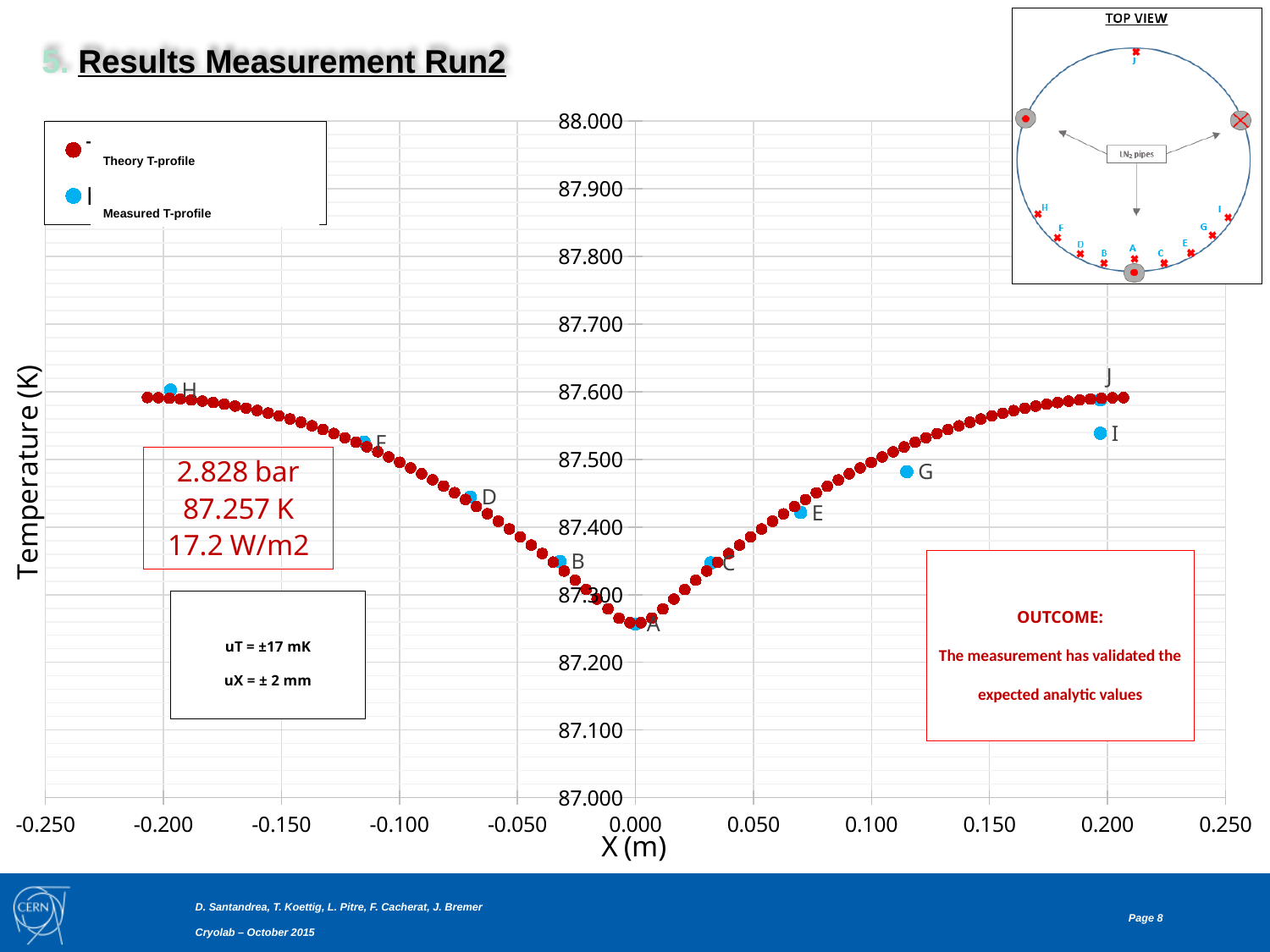
Is the measured temperature at point A greater or less than 87.300? less How many labelled measured points (A to J) are plotted on the chart? 10 What are the two series named in the chart legend? Theory T-profile and Measured T-profile Which measured point has the higher temperature, H or A? H What kind of chart is shown on the slide? scatter chart How many series does the chart legend list? 2 Do the theory T-profile values rise or fall as X goes from 0.000 to 0.200? rise Which labelled measured point has the lowest temperature? A Is the measured temperature at point H greater or less than 87.500? greater Which measured point has the higher temperature, G or E? G What is the label of the vertical axis of the chart? Temperature (K) Is the measured temperature at point G greater or less than 87.400? greater